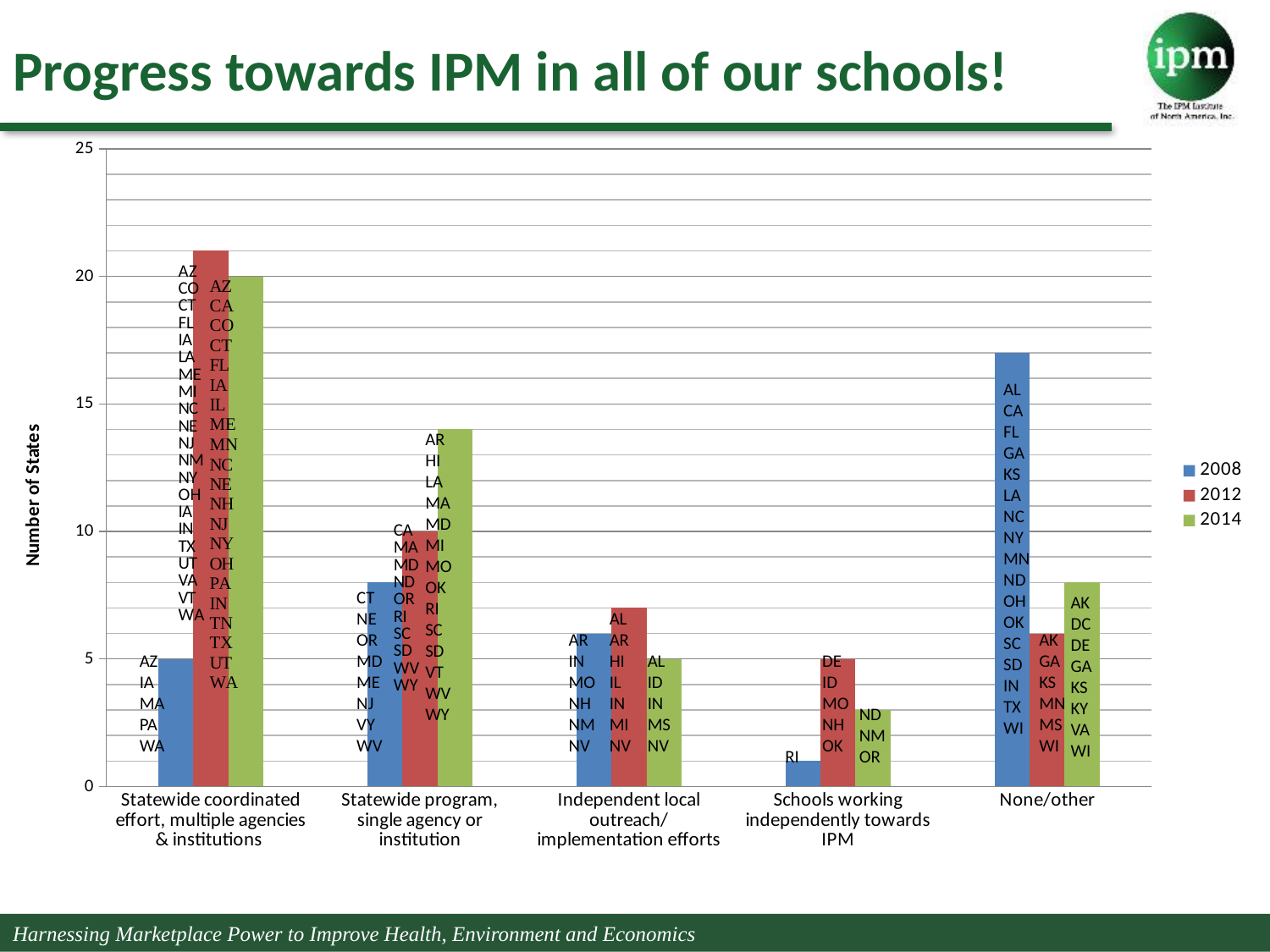
For 'Statewide program, single agency or institution', which is larger: the 2008 value or the 2014 value? 2014 What is the 2012 value for 'Statewide program, single agency or institution'? 10 How many categories are shown along the x axis? 5 What is the title of the y axis? Number of States Which category has the highest 2012 value? Statewide coordinated effort, multiple agencies & institutions How many series does the legend list? 3 What is the 2014 value for 'Statewide coordinated effort, multiple agencies & institutions'? 20 Which category has the lowest 2008 value? Schools working independently towards IPM What is the 2008 value for 'Statewide coordinated effort, multiple agencies & institutions'? 5 Is the 2012 value for 'Statewide coordinated effort, multiple agencies & institutions' greater or less than 20? greater Which category has the highest 2008 value? None/other What type of chart is shown on the slide? Bar chart